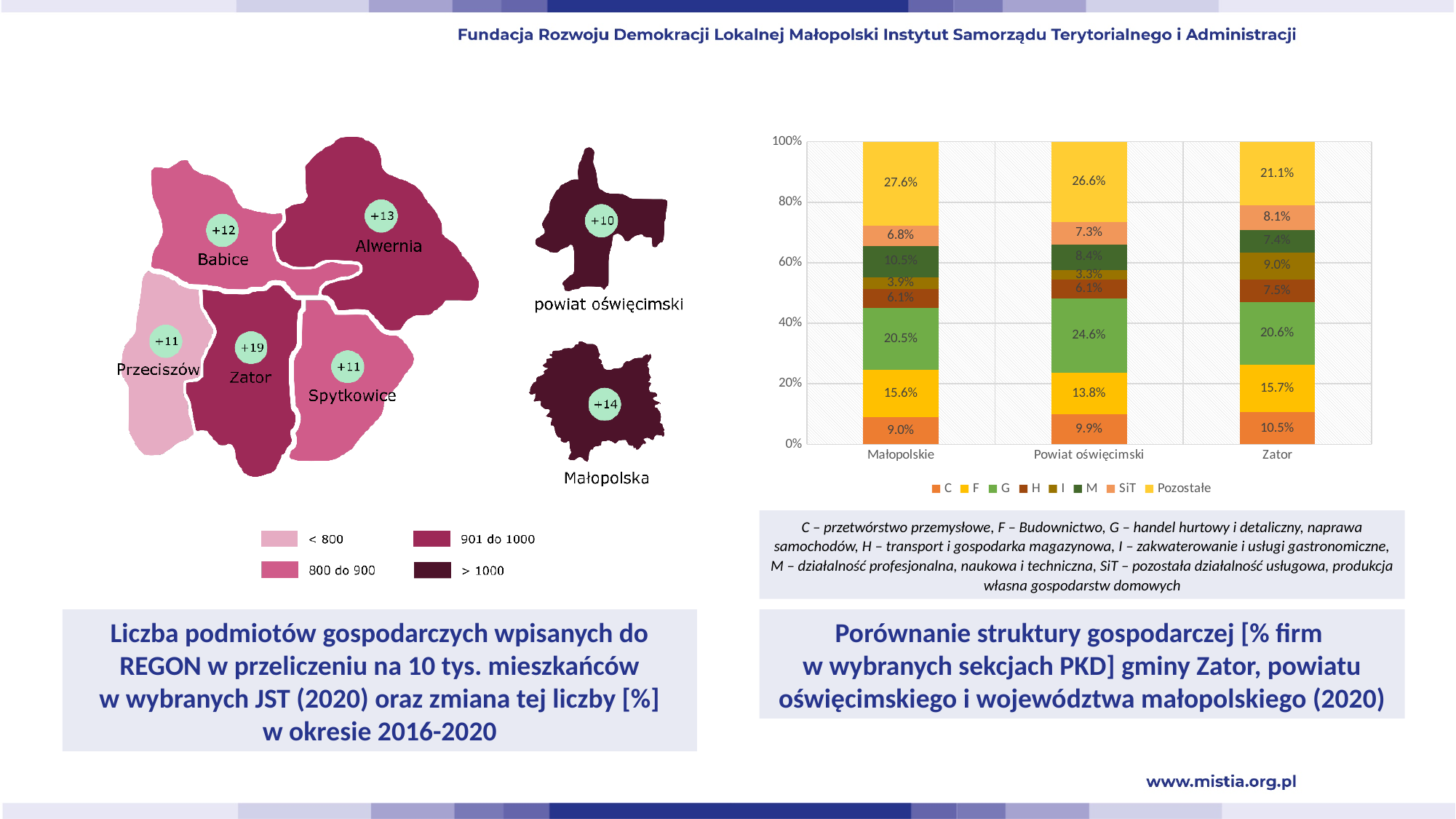
In the stacked bar chart on the right, what is the difference in percentage points between the Pozostałe share for Małopolskie and for Zator? 6.5 In the stacked bar chart on the right, what is the value of the Pozostałe segment for Zator? 21.1% How many series does the legend of the stacked bar chart on the right list? 8 In the stacked bar chart on the right, which category has the highest share for section G? Powiat oświęcimski In the stacked bar chart on the right, what is the value of section I for Zator? 9.0% How many categories are shown on the x axis of the stacked bar chart on the right? 3 In the stacked bar chart on the right, which category has the lowest share for Pozostałe? Zator In the stacked bar chart on the right, what share does section C have for Małopolskie? 9.0% What type of chart is shown on the right side of the slide? Stacked bar chart In the stacked bar chart on the right, is the section M share larger for Małopolskie or for Zator? Małopolskie In the stacked bar chart on the right, what share does section G have for Powiat oświęcimski? 24.6% On the map on the left, which municipality shows the largest change value? Zator (+19)